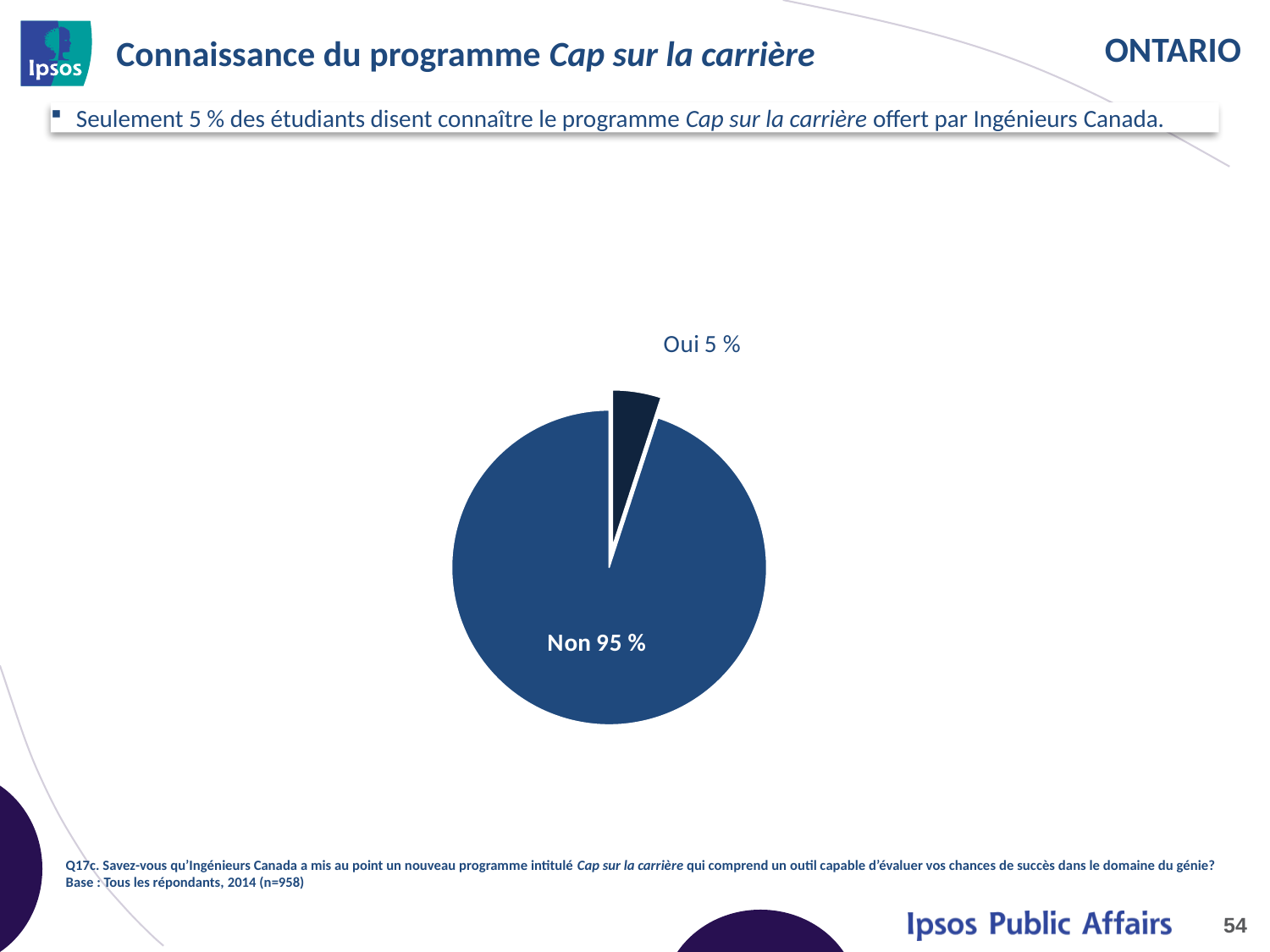
What share of the pie does the "Oui" slice represent? 5 % Which slice of the pie is the largest? Non What is the sample size (n) stated in the base note below the chart? 958 What is the title of the slide containing the chart? Connaissance du programme Cap sur la carrière Which is larger, the "Oui" slice or the "Non" slice? Non How many slices does the pie chart have? 2 Which slice of the pie is the smallest? Oui What is the total of the two slices shown in the pie chart? 100 % What percentage of students answered "Oui" (yes) to knowing the Cap sur la carrière program? 5 % What percentage of students answered "Non" (no)? 95 % What is the difference in percentage points between the "Non" and "Oui" slices? 90 What type of chart is shown on the slide? pie chart